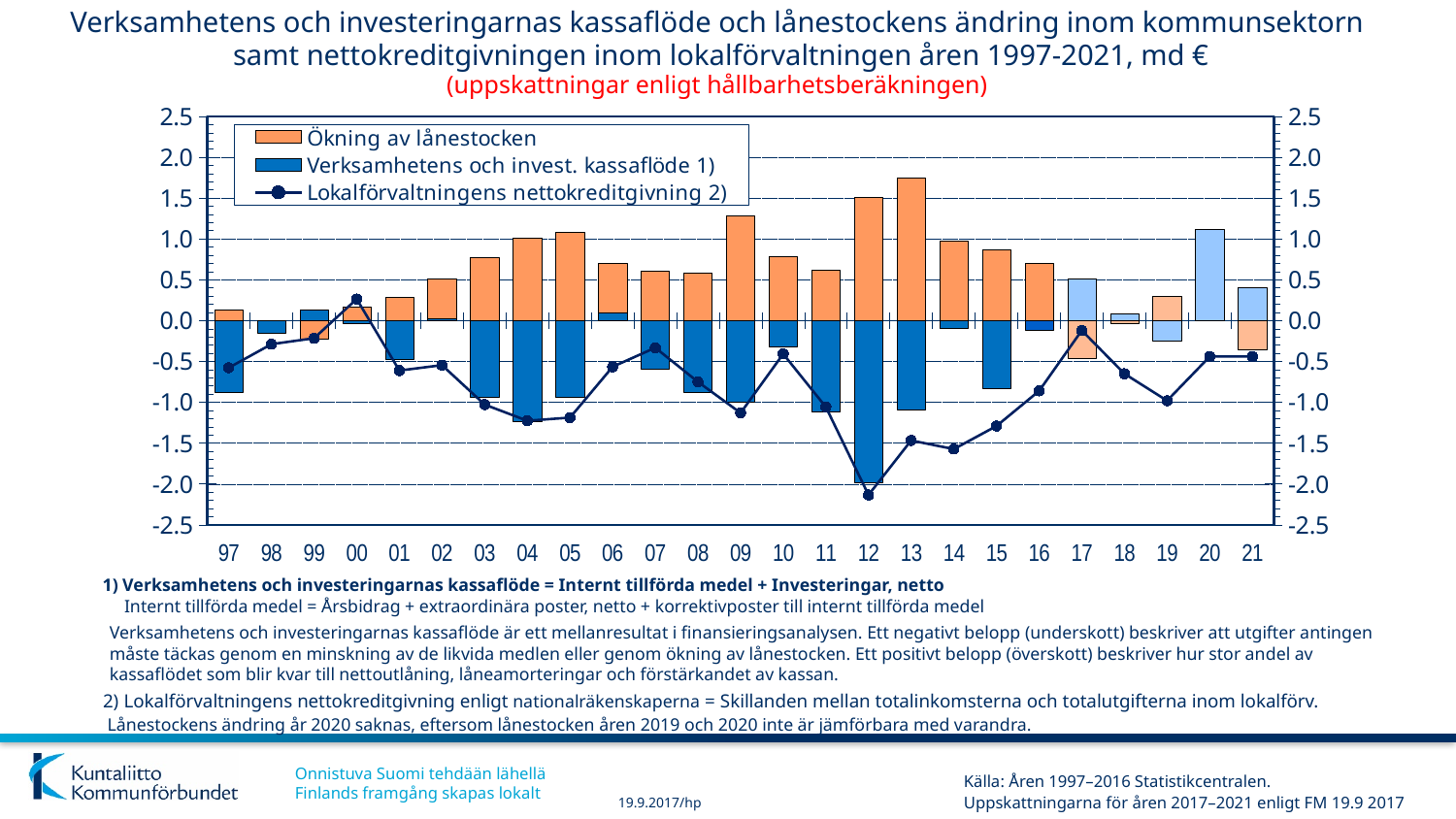
In which year does the line for Lokalförvaltningens nettokreditgivning reach its lowest point? 12 Is the value of Lokalförvaltningens nettokreditgivning in 2009 greater or less than -1.0? less In which year is the bar for Ökning av lånestocken the highest? 13 Which colour represents Ökning av lånestocken in the chart? Orange Do the bars for Ökning av lånestocken rise or fall from 2013 to 2018? fall How many years are shown along the x axis of the chart? 25 How many series does the chart legend list? 3 Is the value of Ökning av lånestocken in 2013 greater or less than 1.5? greater Does the line for Lokalförvaltningens nettokreditgivning rise or fall from 2012 to 2017? rise What kind of chart is shown on the slide? A combined bar and line chart Is the value of Verksamhetens och invest. kassaflöde in 2015 greater or less than -0.5? less In which year does the line for Lokalförvaltningens nettokreditgivning reach its highest point? 00